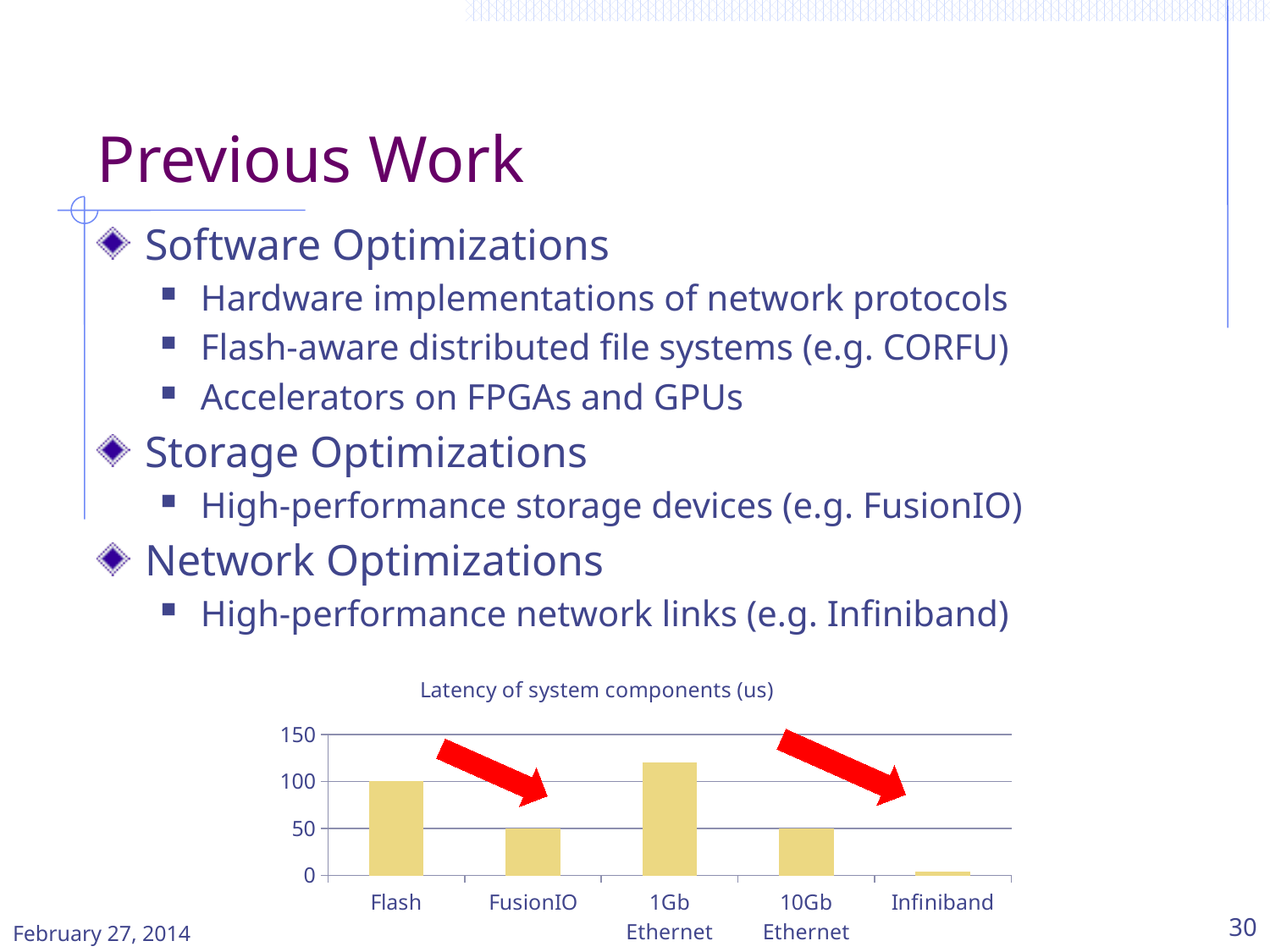
Which has the higher latency, Flash or FusionIO? Flash Is the latency for Infiniband greater or less than 50? less How many system components are plotted in the chart? 5 What kind of chart is shown on the slide? bar chart Which system component has the lowest latency in the chart? Infiniband Is the latency for 1Gb Ethernet greater or less than 100? greater Is the latency for 1Gb Ethernet greater or less than 150? less What is the latency value shown for FusionIO? 50 Which has the higher latency, 1Gb Ethernet or 10Gb Ethernet? 1Gb Ethernet What is the title of the chart? Latency of system components (us) Which system component has the highest latency in the chart? 1Gb Ethernet What is the latency value shown for Flash? 100